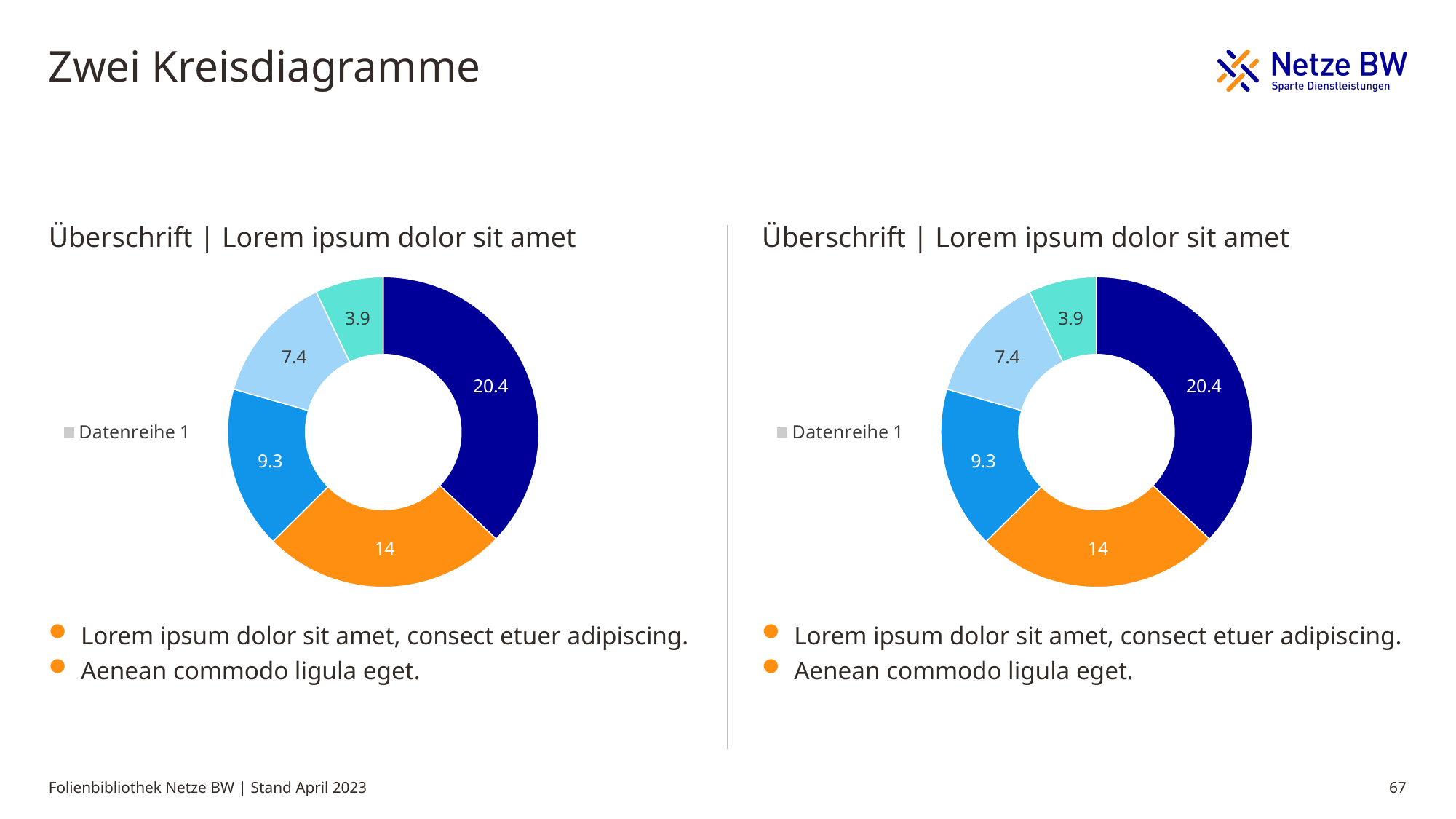
In the right chart, what value is shown on the orange slice? 14 In the right chart, what value is shown on the light blue slice? 7.4 In the left chart, what value is shown on the teal slice? 3.9 In the left chart, what is the difference between the dark blue slice (20.4) and the orange slice (14)? 6.4 In the right chart, which is larger: the medium blue slice or the light blue slice? The medium blue slice (9.3) What kind of chart is shown on the left side of the slide? Doughnut (pie) chart How many slices does the left chart have? 5 In the left chart, which slice has the largest value? The dark blue slice (20.4) How many series does the legend of the right chart list? 1 In the right chart, which slice has the smallest value? The teal slice (3.9) In the left chart, what value is shown on the dark blue slice? 20.4 What is the legend entry shown next to the left chart? Datenreihe 1